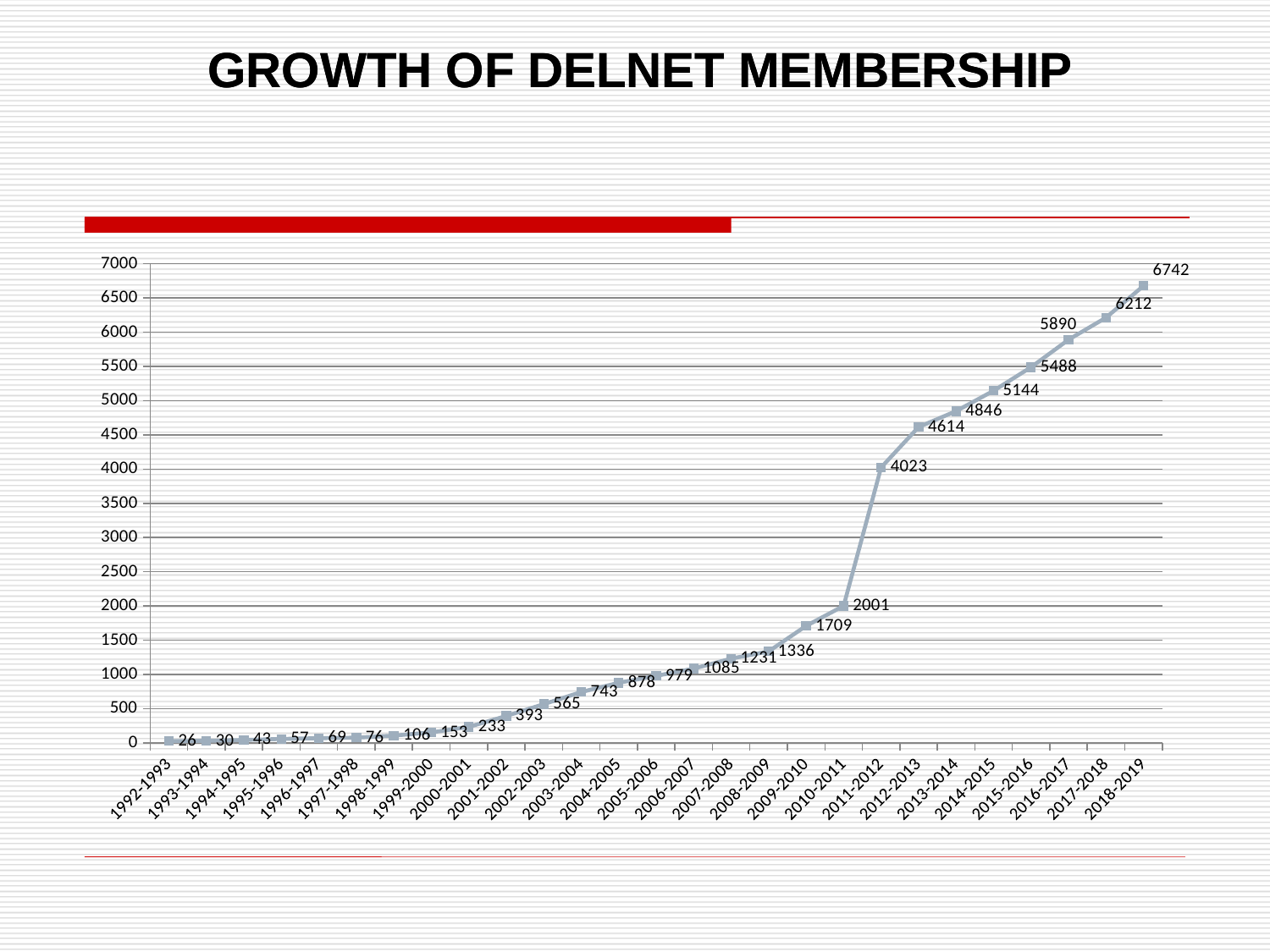
What is the membership value shown for 2011-2012? 4023 How many periods are plotted on the x axis? 27 What is the title of the slide containing the chart? GROWTH OF DELNET MEMBERSHIP Is the membership value for 2016-2017 greater or less than 5500? greater What is the DELNET membership value for 2018-2019? 6742 Which period has the highest membership value? 2018-2019 What kind of chart is shown on the slide? Line chart Which is larger, the membership value for 2009-2010 or for 2008-2009? 2009-2010 Which period has the lowest membership value? 1992-1993 Do the membership values rise or fall from 1992-1993 to 2018-2019? Rise What is the difference between the membership values for 2011-2012 and 2010-2011? 2022 What is the membership value shown for 2003-2004? 743